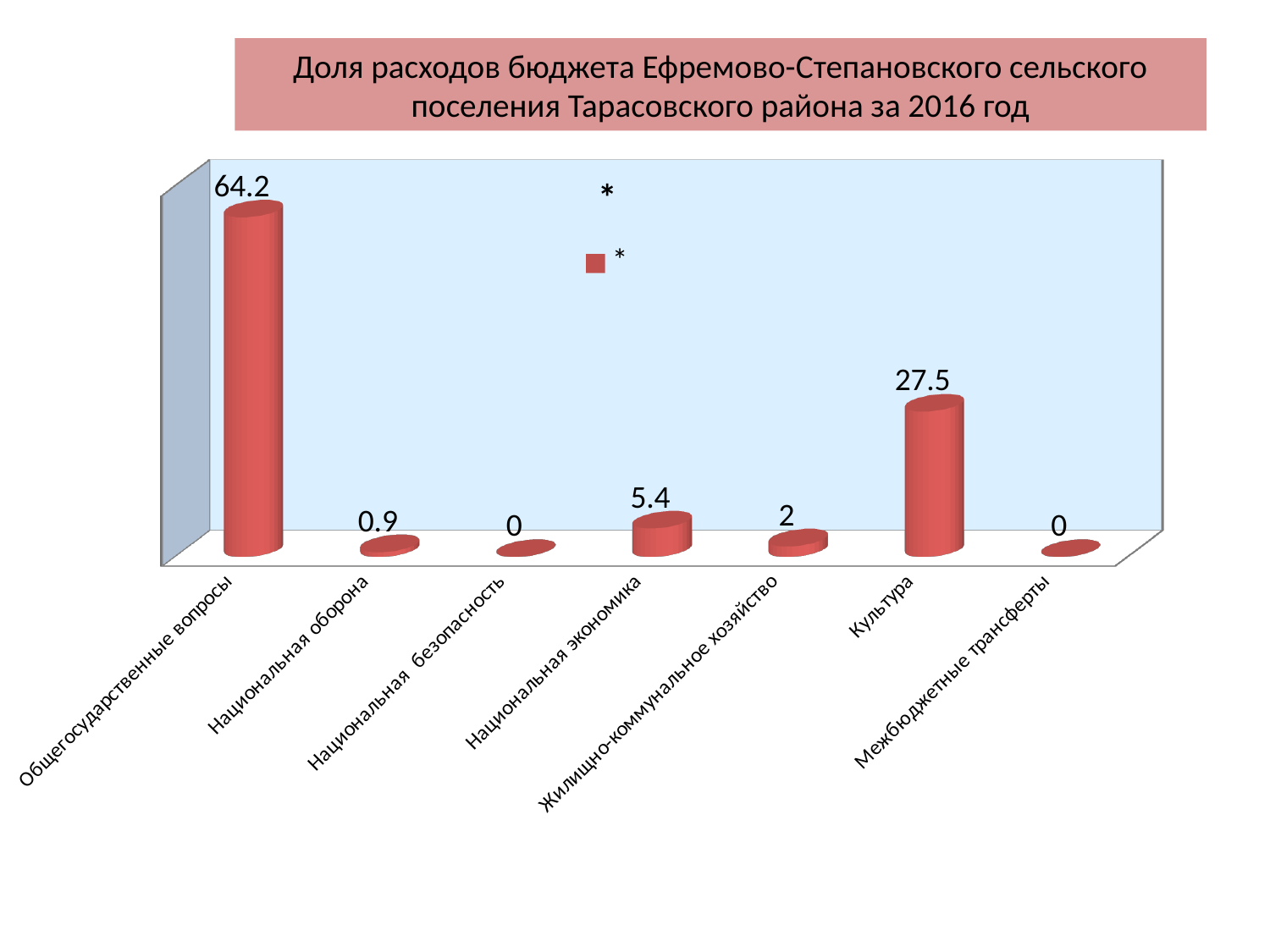
What is the value for Жилищно-коммунальное хозяйство? 2 What is the title of the chart? Доля расходов бюджета Ефремово-Степановского сельского поселения Тарасовского района за 2016 год How many categories have a value of 0? 2 What kind of chart is this? bar chart Which category has the highest value? Общегосударственные вопросы What is the value for Общегосударственные вопросы? 64.2 What is the value for Национальная оборона? 0.9 How many categories are shown on the x axis? 7 What is the value for Культура? 27.5 What is the difference between the values for Общегосударственные вопросы and Культура? 36.7 What is the value for Национальная экономика? 5.4 Which is larger, the value for Национальная экономика or the value for Жилищно-коммунальное хозяйство? Национальная экономика